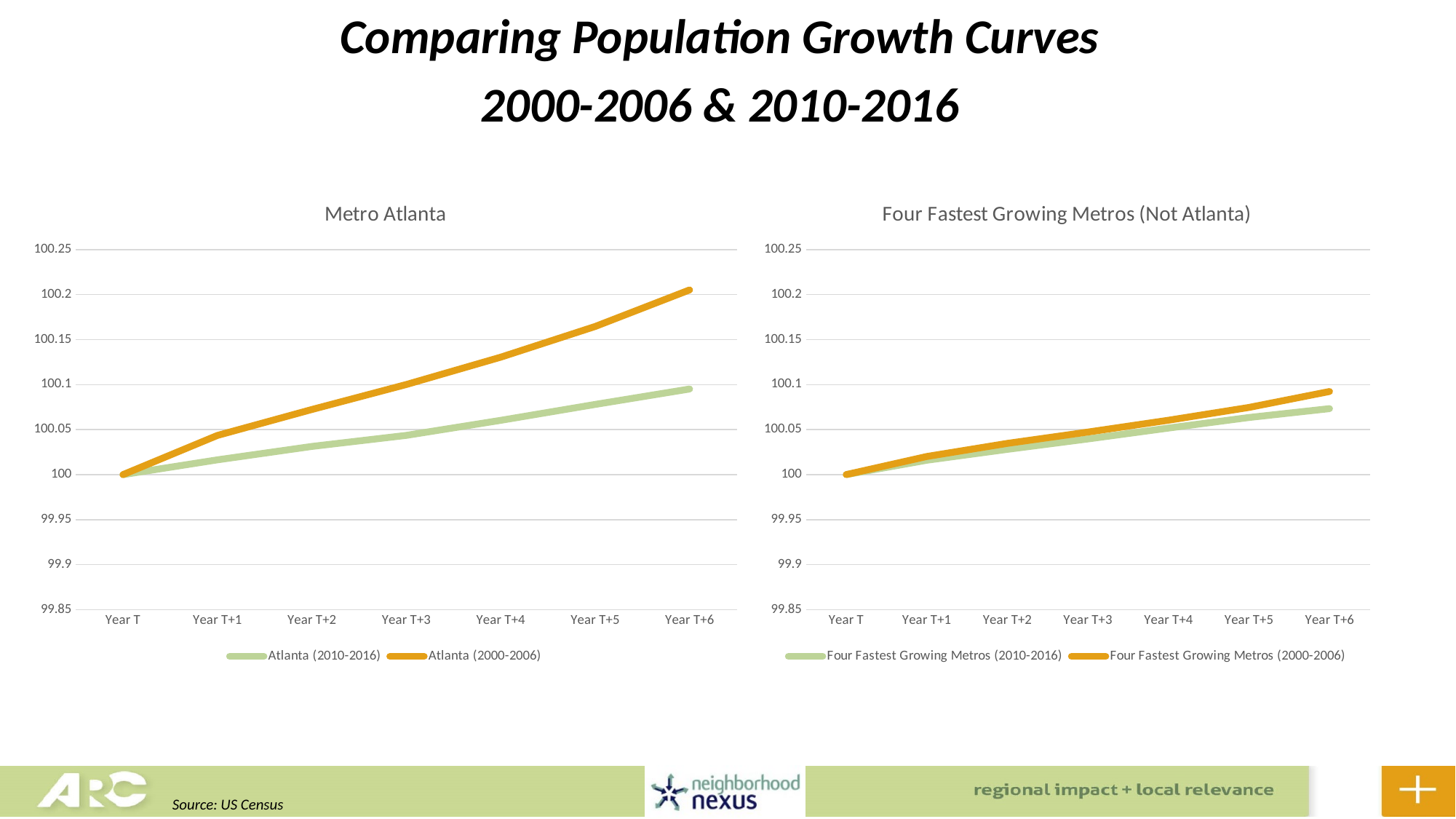
In the Four Fastest Growing Metros (Not Atlanta) chart, is the value of Four Fastest Growing Metros (2010-2016) at Year T+6 greater or less than 100.05? greater What type of chart is the Metro Atlanta chart? line chart In the Four Fastest Growing Metros (Not Atlanta) chart, is the value of Four Fastest Growing Metros (2000-2006) at Year T+6 greater or less than 100.1? less In the Metro Atlanta chart, which series is higher at Year T+6, Atlanta (2010-2016) or Atlanta (2000-2006)? Atlanta (2000-2006) How many series does the legend of the Metro Atlanta chart list? 2 How many points along the x axis does the Four Fastest Growing Metros (Not Atlanta) chart have? 7 What colour is the line for Atlanta (2000-2006) in the Metro Atlanta chart? orange In the Metro Atlanta chart, what is the value of Atlanta (2000-2006) at Year T? 100 In the Four Fastest Growing Metros (Not Atlanta) chart, do the values of Four Fastest Growing Metros (2010-2016) rise or fall from Year T to Year T+6? rise In the Metro Atlanta chart, do the values of Atlanta (2000-2006) rise or fall from Year T to Year T+6? rise